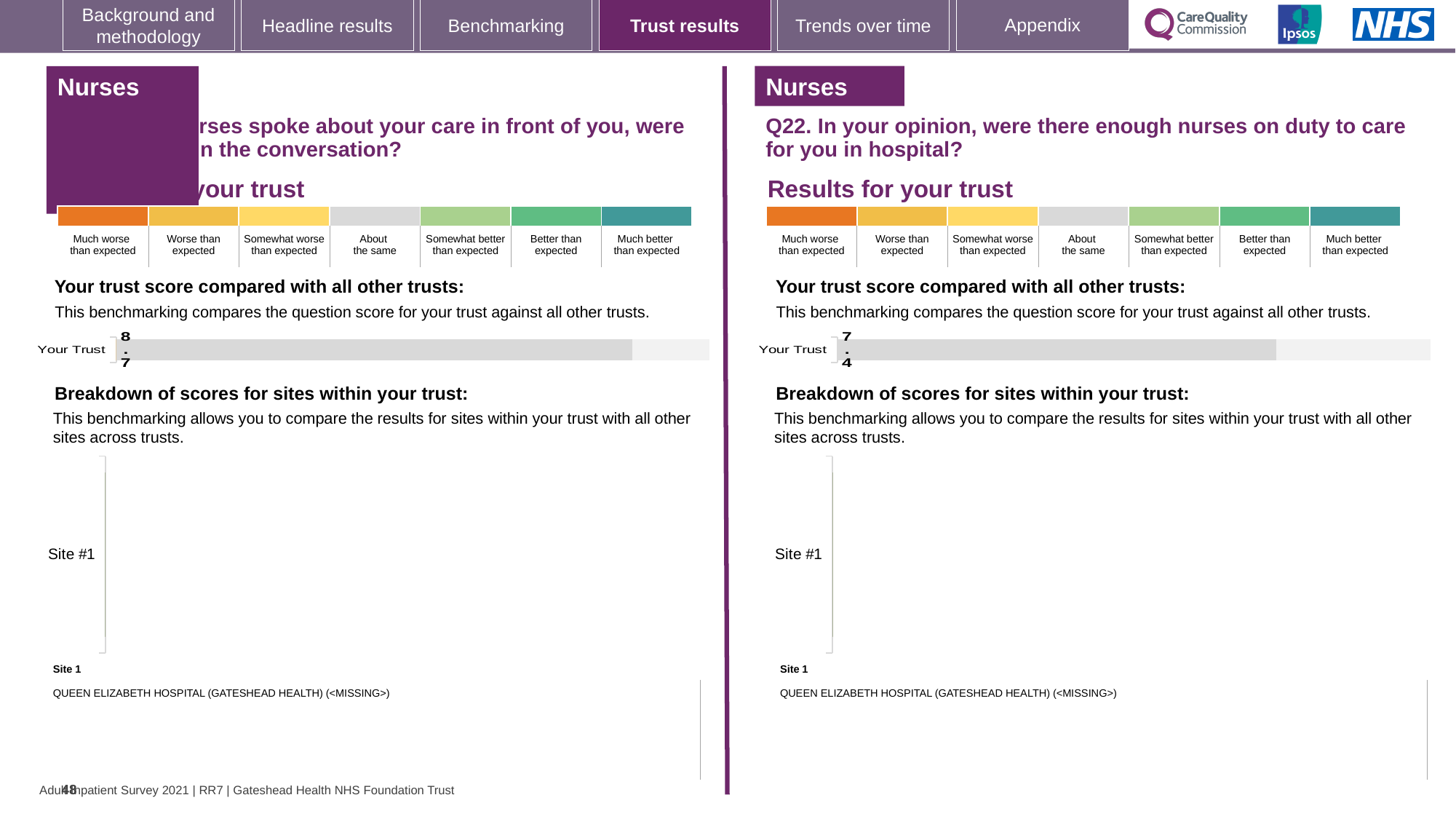
What is the category label on the bar in the right-hand 'Your trust score compared with all other trusts' chart? Your Trust How many categories are plotted in the left-hand 'Your trust score compared with all other trusts' chart? 1 What is the difference between the Your Trust score in the left-hand chart (8.7) and the Your Trust score in the right-hand Q22 chart (7.4)? 1.3 How many sites are listed in the right-hand 'Breakdown of scores for sites within your trust' chart? 1 What is the label of the single site shown in the left-hand 'Breakdown of scores for sites within your trust' chart? Site #1 What kind of chart is used to show 'Your trust score compared with all other trusts' on the right-hand side of the slide? Bar chart Which trust score is larger: the one in the left-hand chart or the one in the right-hand Q22 chart? The left-hand chart (8.7) In the right-hand chart for Q22 ('Your trust score compared with all other trusts'), what is the score shown for Your Trust? 7.4 In the left-hand 'Your trust score compared with all other trusts' chart, what is the score shown for Your Trust? 8.7